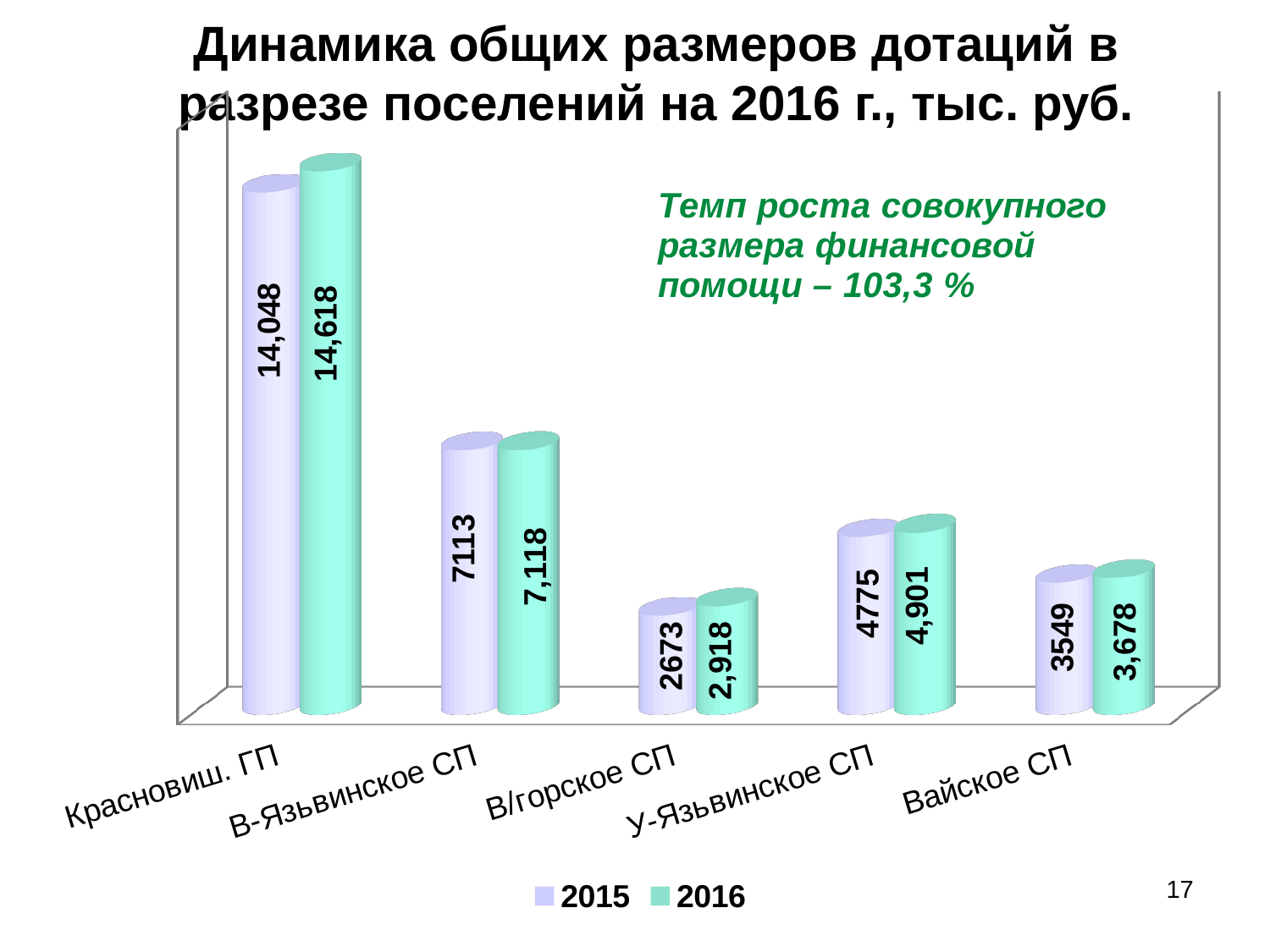
How many categories are shown on the x axis? 5 What is the value for У-Язьвинское СП in the 2015 series? 4775 What kind of chart is shown on the slide? Bar chart Which category has the lowest value in the 2015 series? В/горское СП What is the value for Вайское СП in the 2016 series? 3,678 What is the difference between the 2016 and 2015 values for Красновиш. ГП? 570 What is the difference between the 2016 and 2015 values for В/горское СП? 245 How many series does the legend list? 2 Which is larger for У-Язьвинское СП: the 2015 value or the 2016 value? 2016 Which category has the highest value in the 2016 series? Красновиш. ГП What is the value for В/горское СП in the 2015 series? 2673 What is the value for Красновиш. ГП in the 2016 series? 14,618